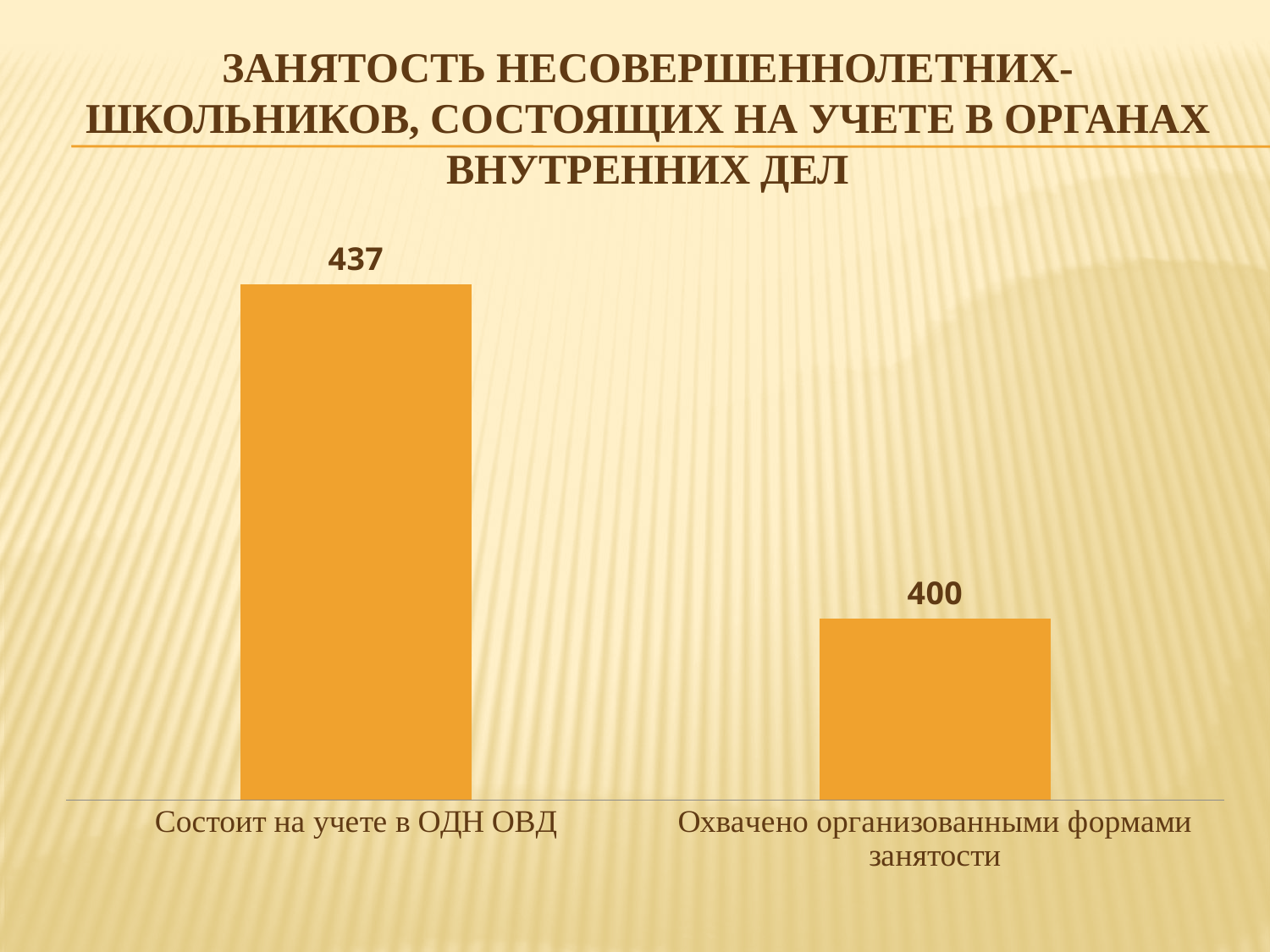
How many categories are shown in the chart? 2 What is the title of the slide? ЗАНЯТОСТЬ НЕСОВЕРШЕННОЛЕТНИХ-ШКОЛЬНИКОВ, СОСТОЯЩИХ НА УЧЕТЕ В ОРГАНАХ ВНУТРЕННИХ ДЕЛ Do the values rise or fall from left to right across the categories? Fall What is the difference between the values for "Состоит на учете в ОДН ОВД" and "Охвачено организованными формами занятости"? 37 Which is larger: the value for "Состоит на учете в ОДН ОВД" or for "Охвачено организованными формами занятости"? Состоит на учете в ОДН ОВД What is the value for "Охвачено организованными формами занятости"? 400 Which category has the lowest value? Охвачено организованными формами занятости What kind of chart is shown on the slide? Bar chart What is the value for "Состоит на учете в ОДН ОВД"? 437 What colour are the bars in the chart? Orange Which category has the highest value? Состоит на учете в ОДН ОВД